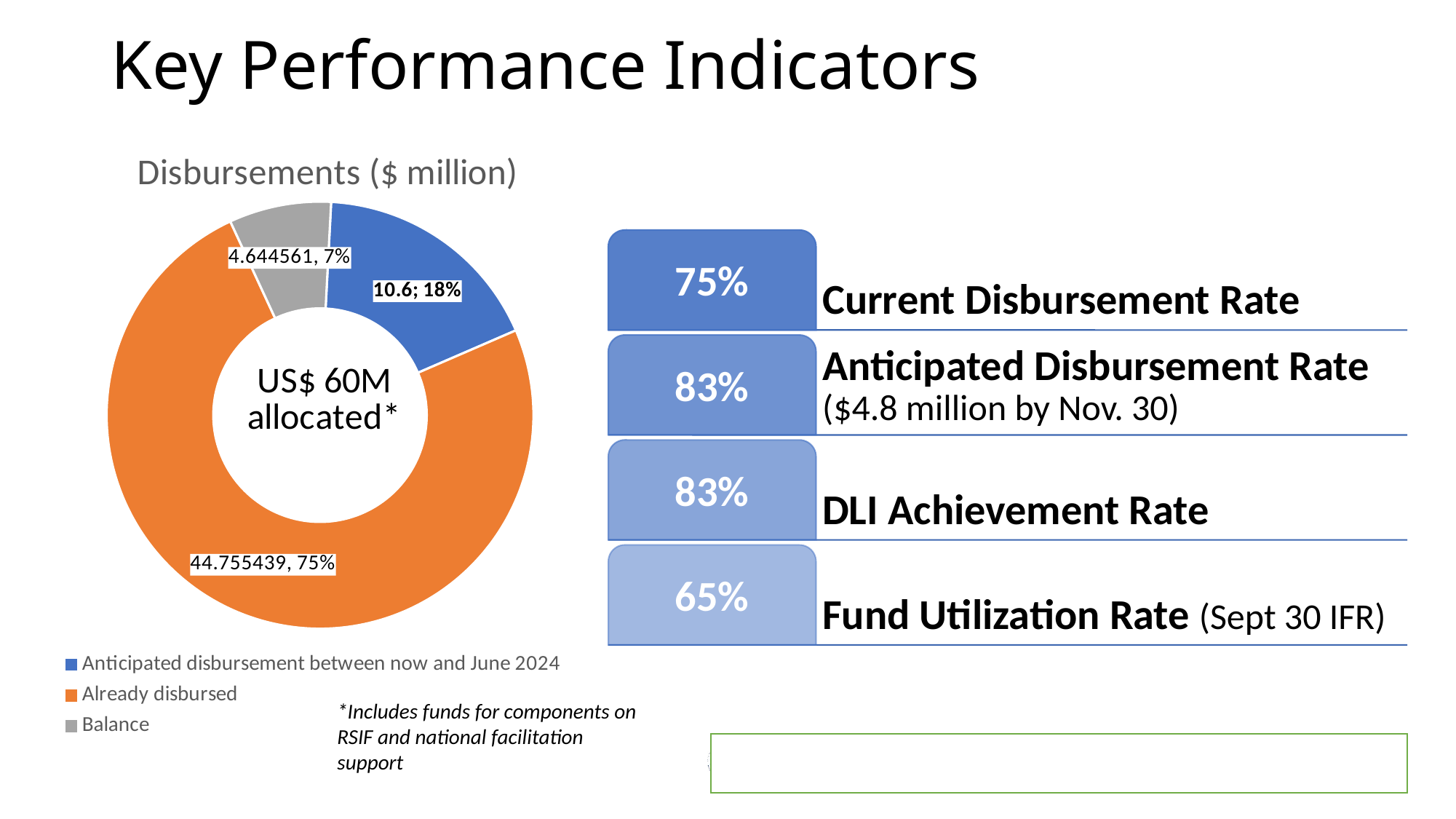
How many categories does the Disbursements chart show? 3 Which is larger in the Disbursements chart: 'Anticipated disbursement between now and June 2024' or 'Balance'? Anticipated disbursement between now and June 2024 What kind of chart is shown under the title 'Disbursements ($ million)'? Doughnut chart What is the value for 'Anticipated disbursement between now and June 2024' in the Disbursements chart? 10.6 Which category has the largest slice in the Disbursements chart? Already disbursed What is the value for 'Already disbursed' in the Disbursements chart? 44.755439 What share of the Disbursements chart does 'Already disbursed' represent? 75% What is the title of the doughnut chart? Disbursements ($ million) What is the value for 'Balance' in the Disbursements chart? 4.644561 What colour is the 'Already disbursed' slice in the Disbursements chart? Orange What share of the Disbursements chart does 'Balance' represent? 7% Which category has the smallest slice in the Disbursements chart? Balance